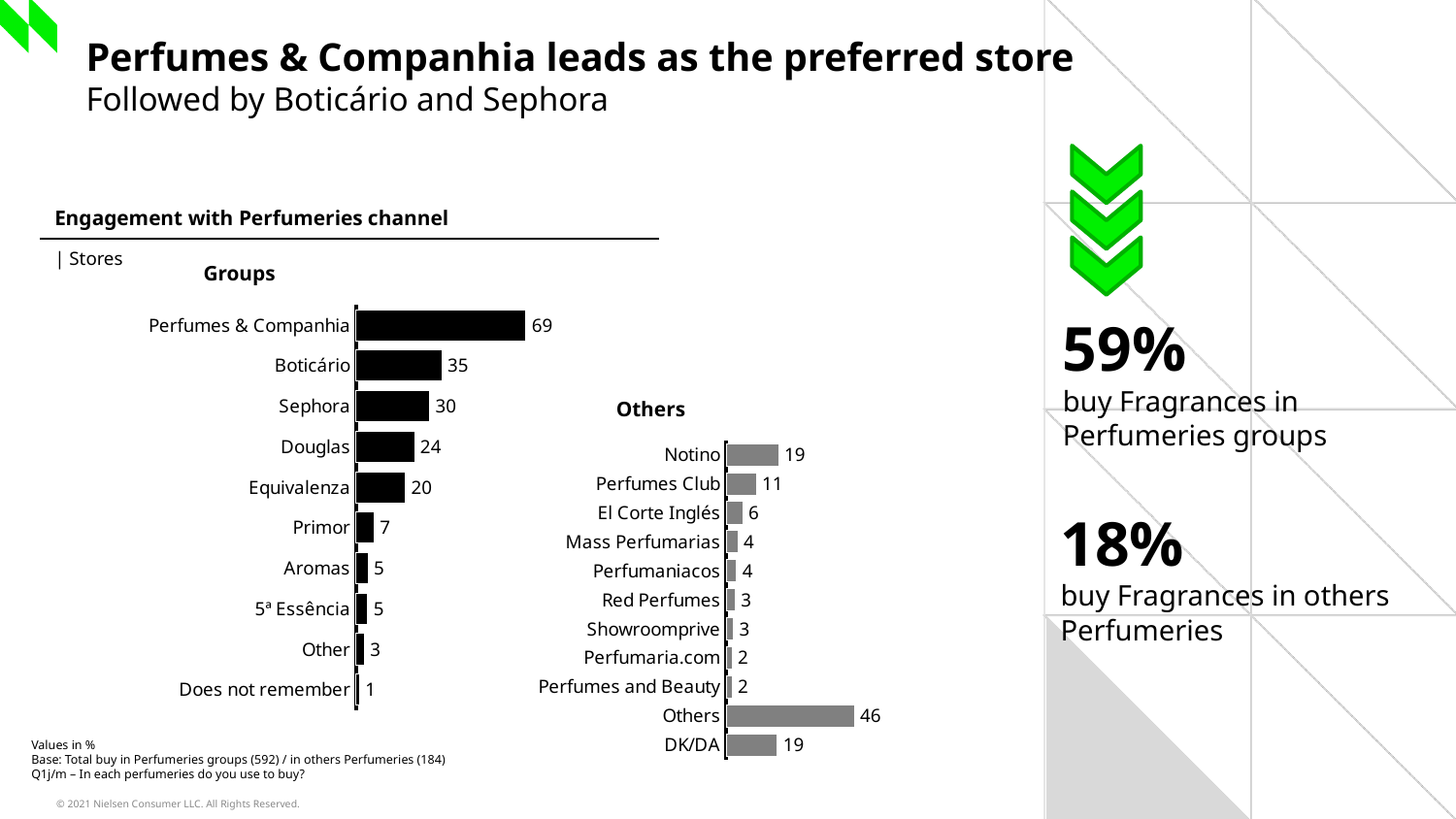
In the Others chart, which is larger, Notino or El Corte Inglés? Notino In the Others chart, how many categories are shown? 11 In the Groups chart, which category has the lowest value? Does not remember In the Others chart, what is the value for Perfumes Club? 11 In the Groups chart, how many categories are shown? 10 In the Groups chart, what is the difference between Boticário and Sephora? 5 In the Groups chart, what is the value for Douglas? 24 In the Groups chart, what is the value for Perfumes & Companhia? 69 In the Others chart, what is the difference between Others and DK/DA? 27 What type of chart is the Groups chart? Bar chart In the Groups chart, which store has the highest value? Perfumes & Companhia In the Others chart, which category has the highest value? Others